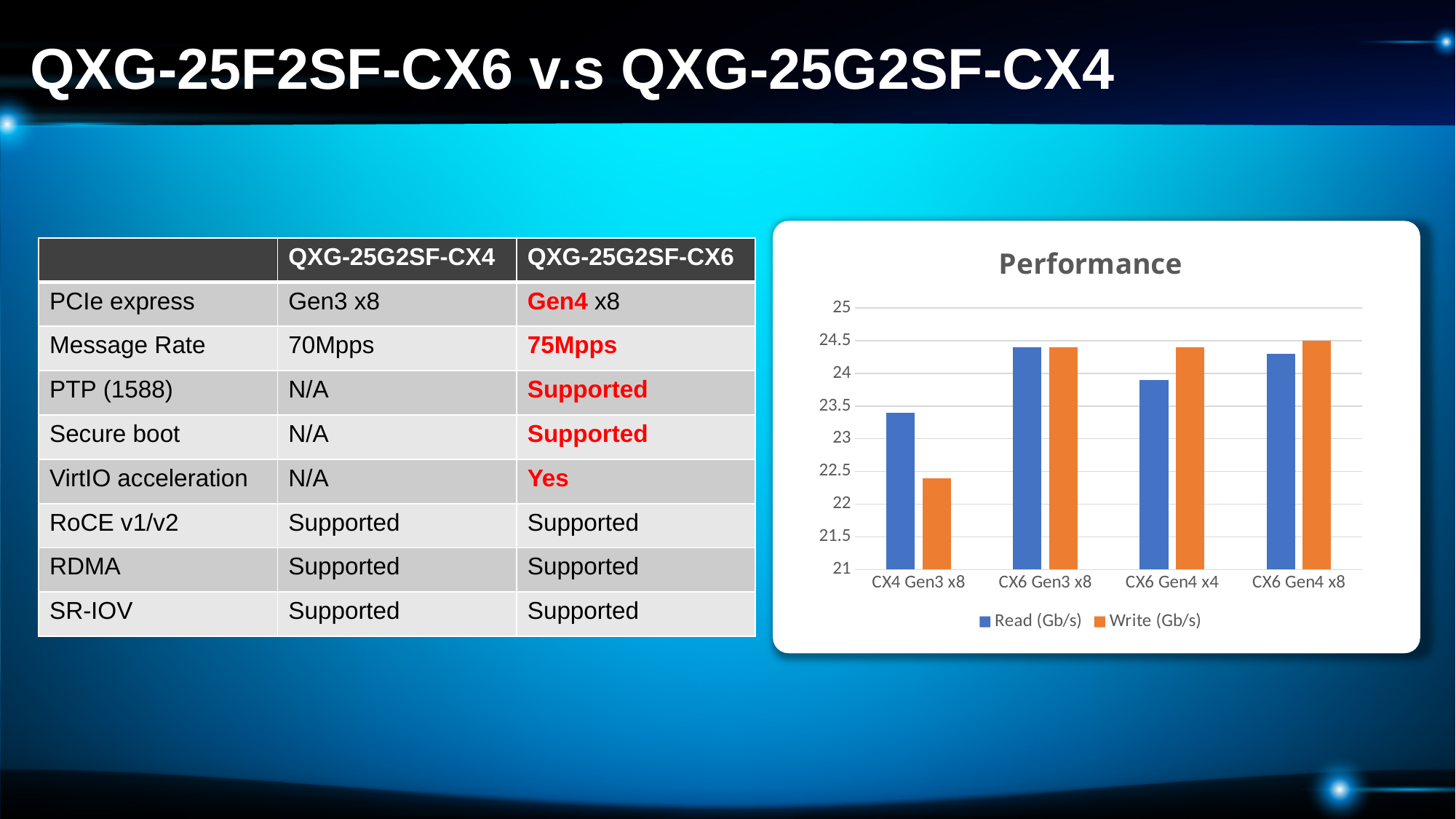
In the Performance chart, is the Read (Gb/s) value for CX6 Gen4 x4 greater or less than 24? less What kind of chart is the Performance chart? bar chart Which category has the lowest Read (Gb/s) value in the Performance chart? CX4 Gen3 x8 Which series in the Performance chart is shown in orange? Write (Gb/s) How many series does the legend of the Performance chart list? 2 In the Performance chart, for CX6 Gen4 x4, which is larger: Read (Gb/s) or Write (Gb/s)? Write (Gb/s) In the Performance chart, for CX4 Gen3 x8, which is larger: Read (Gb/s) or Write (Gb/s)? Read (Gb/s) What is the title of the chart on the slide? Performance In the Performance chart, is the Read (Gb/s) value for CX4 Gen3 x8 greater or less than 23? greater Which category has the lowest Write (Gb/s) value in the Performance chart? CX4 Gen3 x8 In the Performance chart, is the Write (Gb/s) value for CX4 Gen3 x8 greater or less than 23? less How many categories are shown on the x axis of the Performance chart? 4